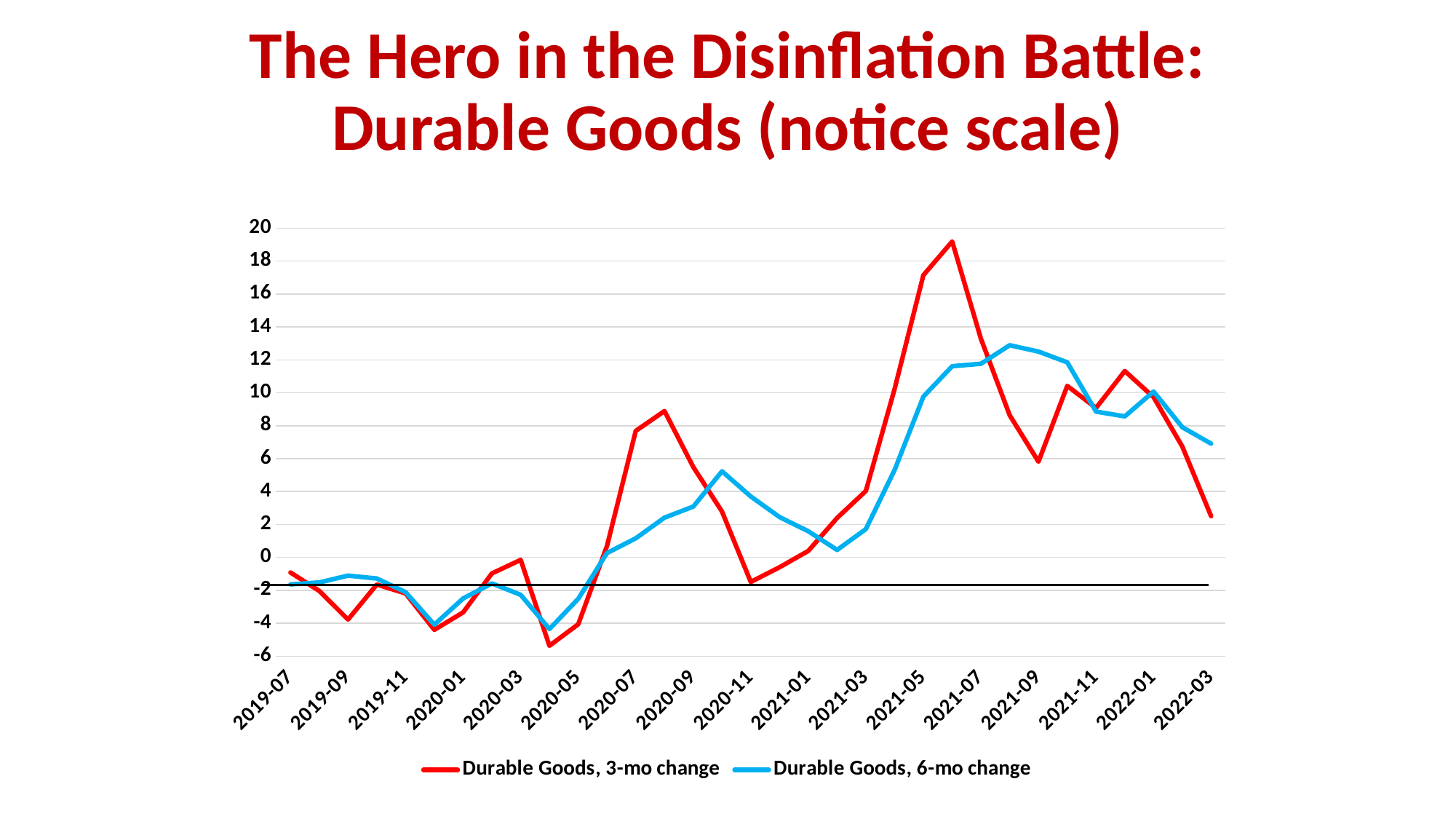
How many series does the legend list? 2 Is the value for Durable Goods, 3-mo change at 2022-03 greater or less than 4? less Is the value for Durable Goods, 3-mo change at 2021-05 greater or less than 14? greater At 2021-05, which series has the larger value, the 3-mo change or the 6-mo change? Durable Goods, 3-mo change What kind of chart is shown on the slide? line chart Is the value for Durable Goods, 6-mo change at 2021-09 greater or less than 10? greater Do both series rise or fall between 2022-01 and 2022-03? fall Which series reaches the highest value on the chart? Durable Goods, 3-mo change What colour is the line for Durable Goods, 3-mo change? red At 2022-03, which series has the larger value, the 3-mo change or the 6-mo change? Durable Goods, 6-mo change Which series reaches the lowest value on the chart? Durable Goods, 3-mo change